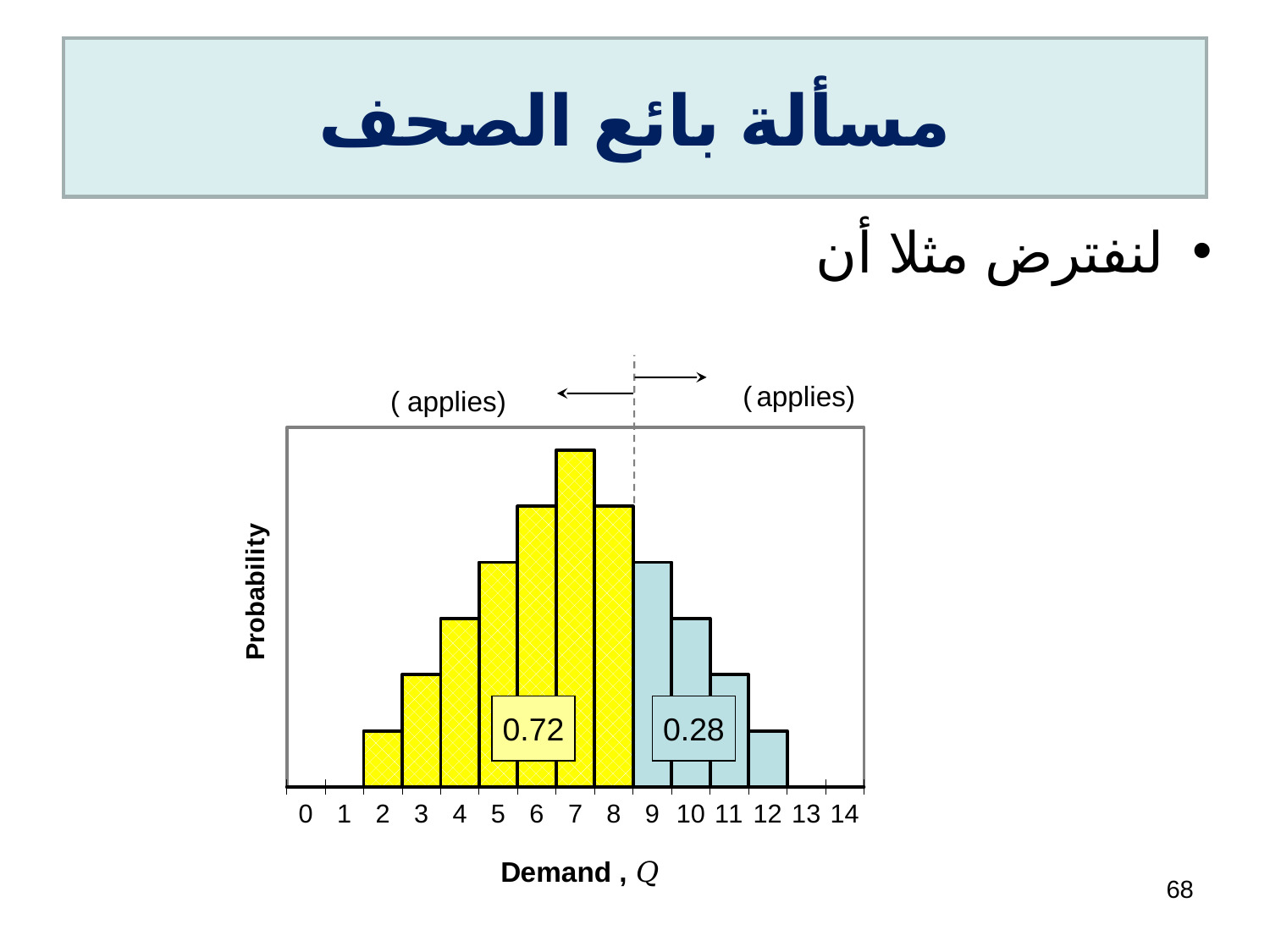
What kind of chart is shown on the slide? bar chart Which bar is taller, the one at demand 7 or the one at demand 8? demand 7 Which bar is taller, the one at demand 4 or the one at demand 10? Neither; they are the same height What is the title of the x axis? Demand, Q How many bars are plotted in the chart? 11 Do the bar heights rise or fall as demand goes from 8 to 12? fall Which demand value has the highest probability bar? 7 How many yellow bars are there in the chart? 7 Do the bar heights rise or fall as demand goes from 2 to 7? rise Which bar is taller, the one at demand 6 or the one at demand 9? demand 6 How many light blue bars are there in the chart? 4 What probability value is printed on the yellow region of the chart? 0.72